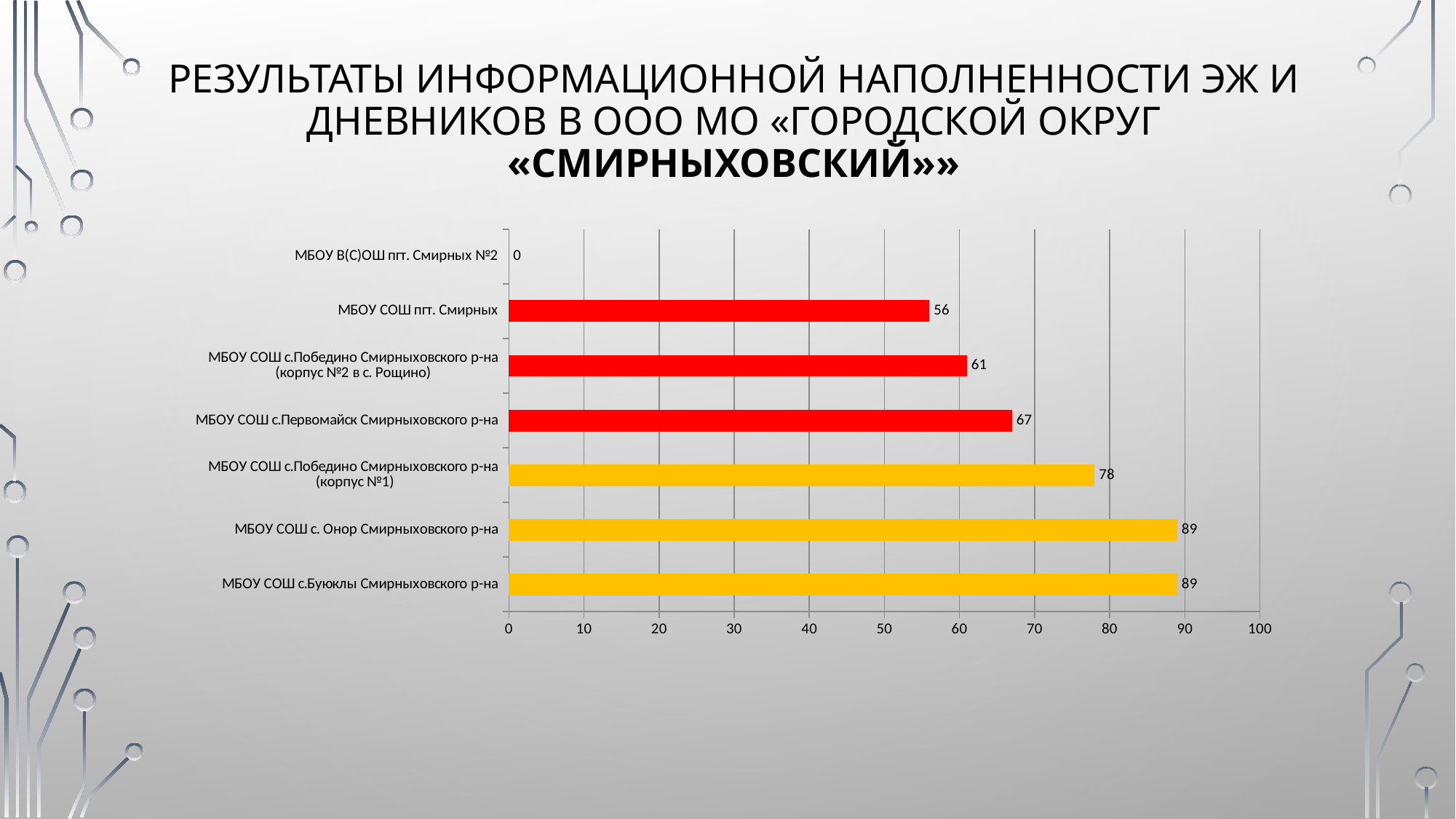
How many categories are shown in the chart? 7 Which category has the lowest value? МБОУ В(С)ОШ пгт. Смирных №2 What is the value for МБОУ СОШ пгт. Смирных? 56 Is the value for МБОУ СОШ с.Буюклы Смирныховского р-на greater or less than 80? greater Which is larger: the value for МБОУ СОШ с.Первомайск Смирныховского р-на or the value for МБОУ СОШ пгт. Смирных? МБОУ СОШ с.Первомайск Смирныховского р-на What is the value for МБОУ СОШ с.Первомайск Смирныховского р-на? 67 What is the value for МБОУ В(С)ОШ пгт. Смирных №2? 0 What is the value for МБОУ СОШ с.Победино Смирныховского р-на (корпус №1)? 78 What is the difference between the values for МБОУ СОШ с. Онор Смирныховского р-на and МБОУ СОШ пгт. Смирных? 33 What is the difference between the values for МБОУ СОШ с.Победино Смирныховского р-на (корпус №1) and МБОУ СОШ с.Победино Смирныховского р-на (корпус №2 в с. Рощино)? 17 What colour are the bars for the three categories with the highest values? yellow What kind of chart is shown on the slide? bar chart